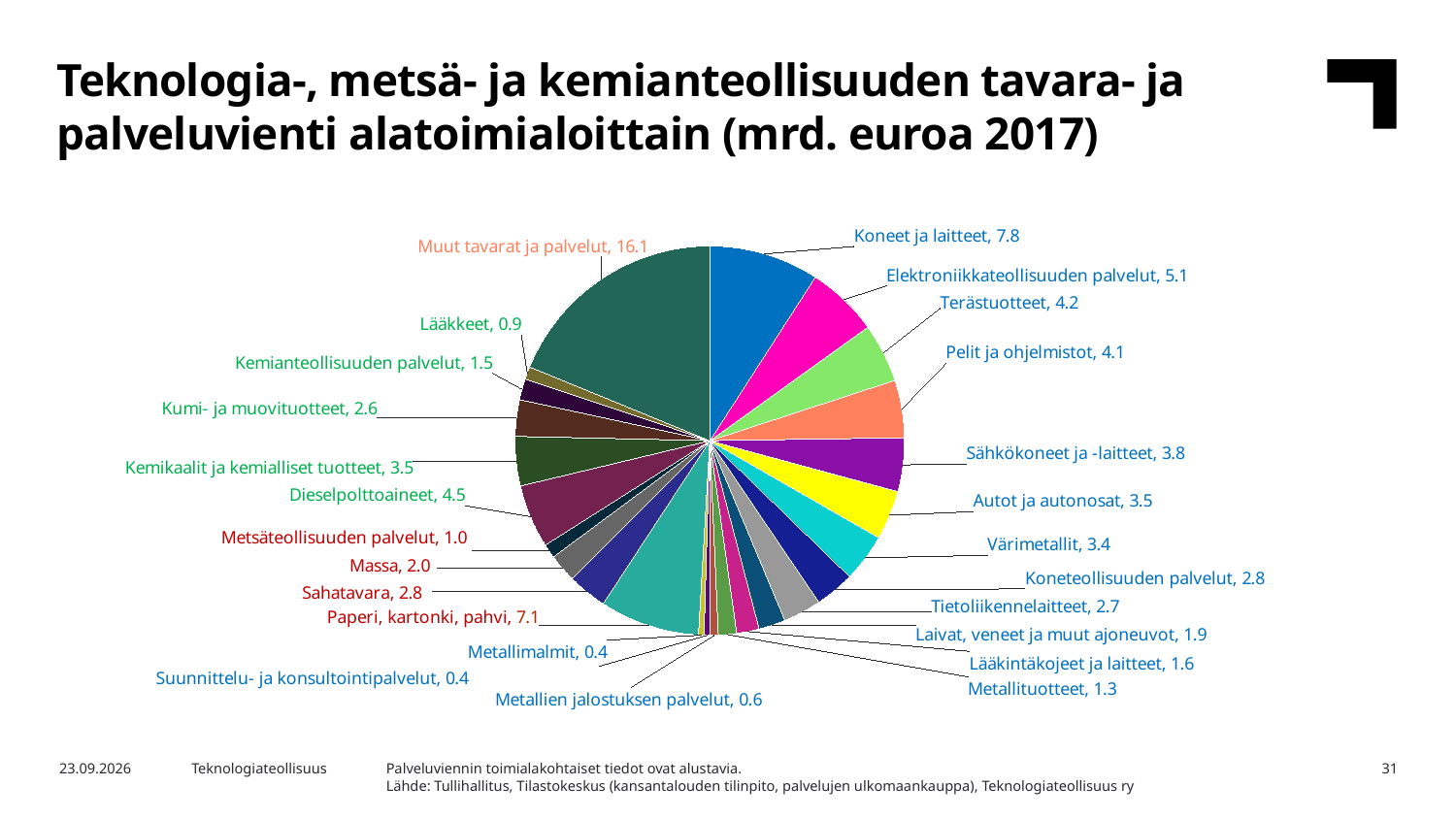
Which category has the largest slice in the pie chart? Muut tavarat ja palvelut What is the value for Paperi, kartonki, pahvi? 7.1 What is the difference between Koneet ja laitteet and Paperi, kartonki, pahvi? 0.7 What type of chart is shown on the slide? pie chart What is the value for Koneet ja laitteet? 7.8 What is the value for Dieselpolttoaineet? 4.5 What is the value for Tietoliikennelaitteet? 2.7 How many slices does the pie chart have? 25 Which is larger, Terästuotteet or Pelit ja ohjelmistot? Terästuotteet What is the value for Lääkkeet? 0.9 What is the difference between Muut tavarat ja palvelut and Koneet ja laitteet? 8.3 What unit and year does the slide title give for the values? mrd. euroa 2017